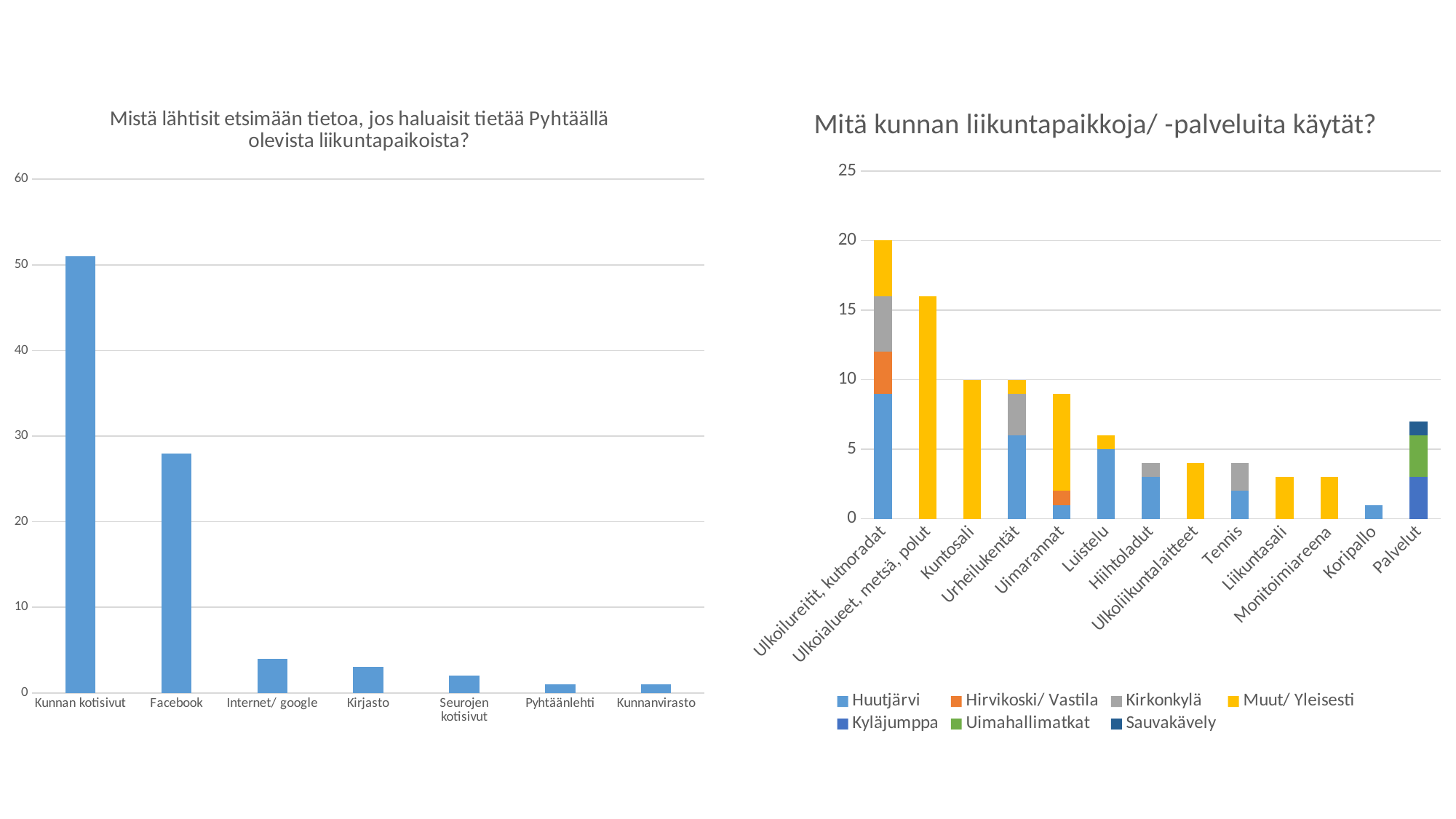
In the left chart, is the value for Facebook greater or less than 20? greater In the left chart, which is larger, the value for Facebook or the value for Kirjasto? Facebook How many categories are shown on the x axis of the right chart? 13 In the right chart, is the total for Koripallo greater or less than 5? less In the left chart, is the value for Internet/ google greater or less than 10? less What kind of chart is the left chart, 'Mistä lähtisit etsimään tietoa...'? bar chart How many series does the legend of the right chart, 'Mitä kunnan liikuntapaikkoja/ -palveluita käytät?', list? 7 How many categories are shown in the left chart? 7 In the right chart, what is the total of the stacked bar for Ulkoilureitit, kutnoradat? 20 In the left chart, which category has the highest value? Kunnan kotisivut In the right chart, what is the value for Kuntosali? 10 In the right chart, which category has the highest total? Ulkoilureitit, kutnoradat